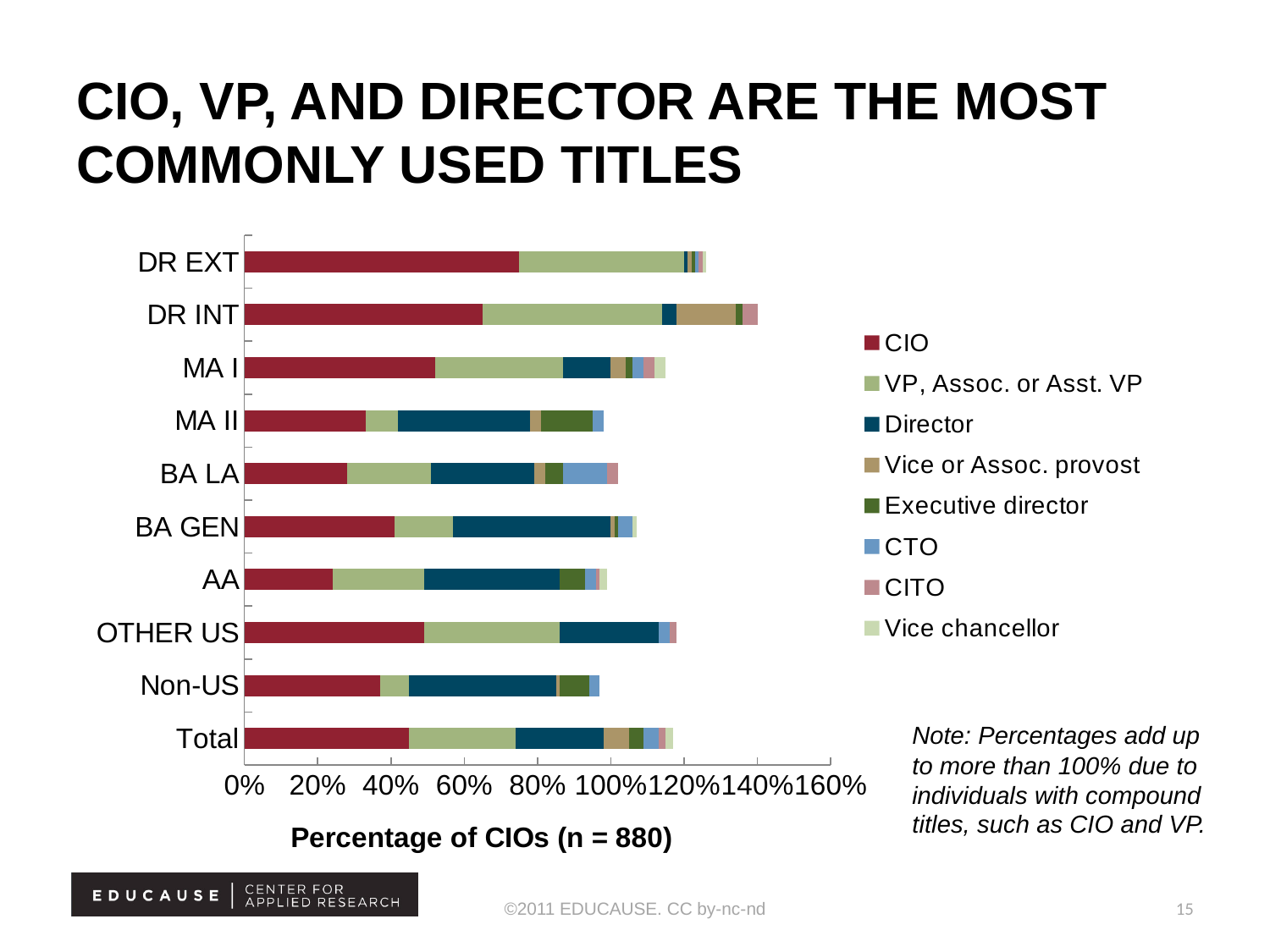
Is the total stacked bar for Non-US greater or less than 100%? less Which series is listed first in the legend? CIO What is the title of the horizontal axis? Percentage of CIOs (n = 880) Which category has the largest CIO segment? DR EXT How many series does the chart's legend list? 8 Which has the larger CIO segment, DR EXT or AA? DR EXT Is the CIO segment for AA greater or less than 40%? less Is the CIO segment for DR EXT greater or less than 60%? greater How many categories are plotted on the vertical axis of the chart? 10 What kind of chart is shown on the slide? Stacked bar chart Which category has the longest total stacked bar? DR INT